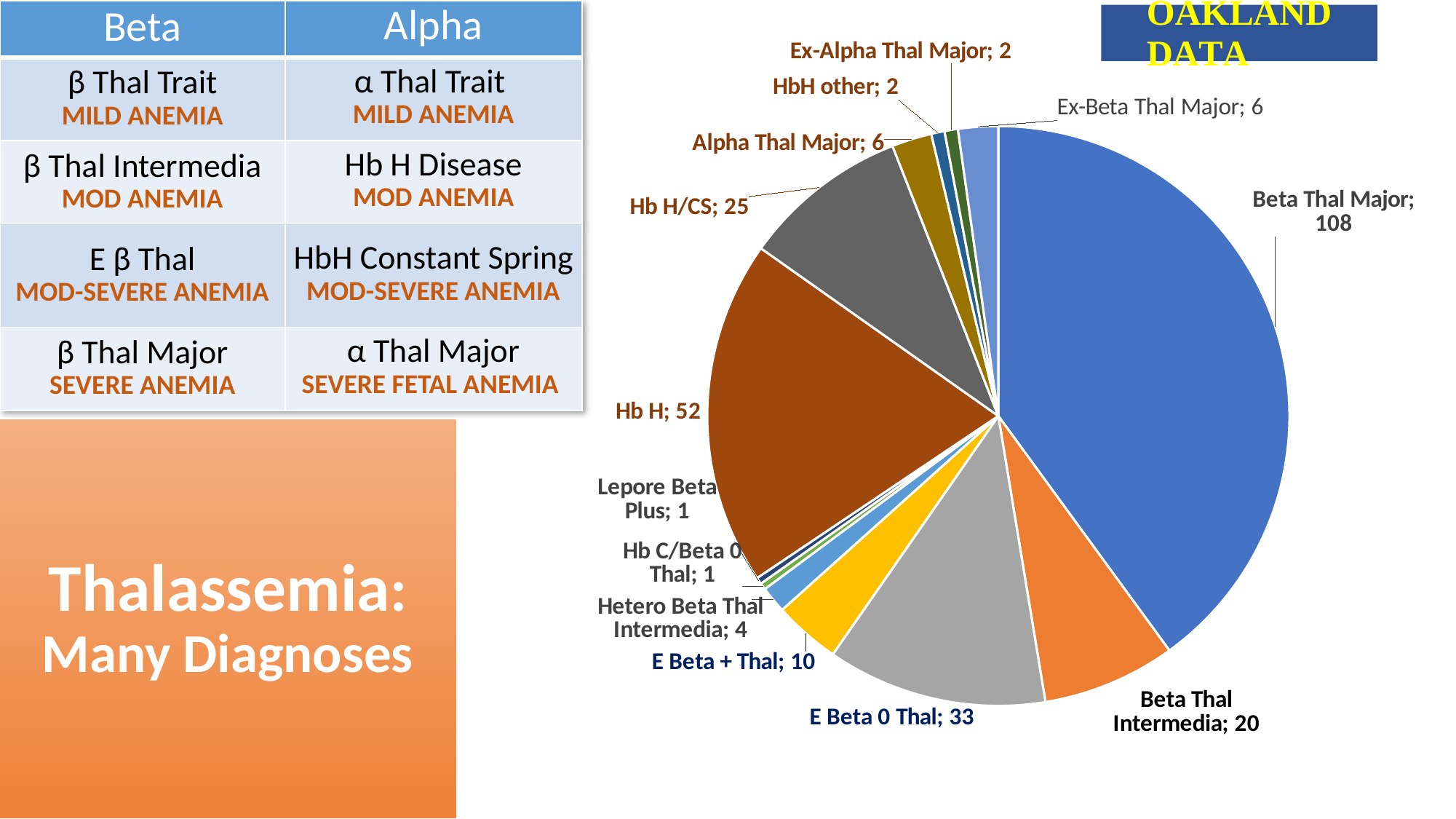
Which category has the largest slice in the pie chart? Beta Thal Major How many slices does the pie chart have? 13 Which is larger in the pie chart, Hb H or E Beta 0 Thal? Hb H What is the value for Beta Thal Major in the pie chart? 108 What is the value for Hetero Beta Thal Intermedia in the pie chart? 4 What share of the pie does Beta Thal Major represent? 40% What is the value for E Beta 0 Thal in the pie chart? 33 What is the value for Hb H/CS in the pie chart? 25 What kind of chart is shown on the slide? Pie chart What is the value for Hb H in the pie chart? 52 What is the difference between the values for E Beta 0 Thal and Beta Thal Intermedia? 13 What is the difference between the values for Beta Thal Major and Hb H? 56